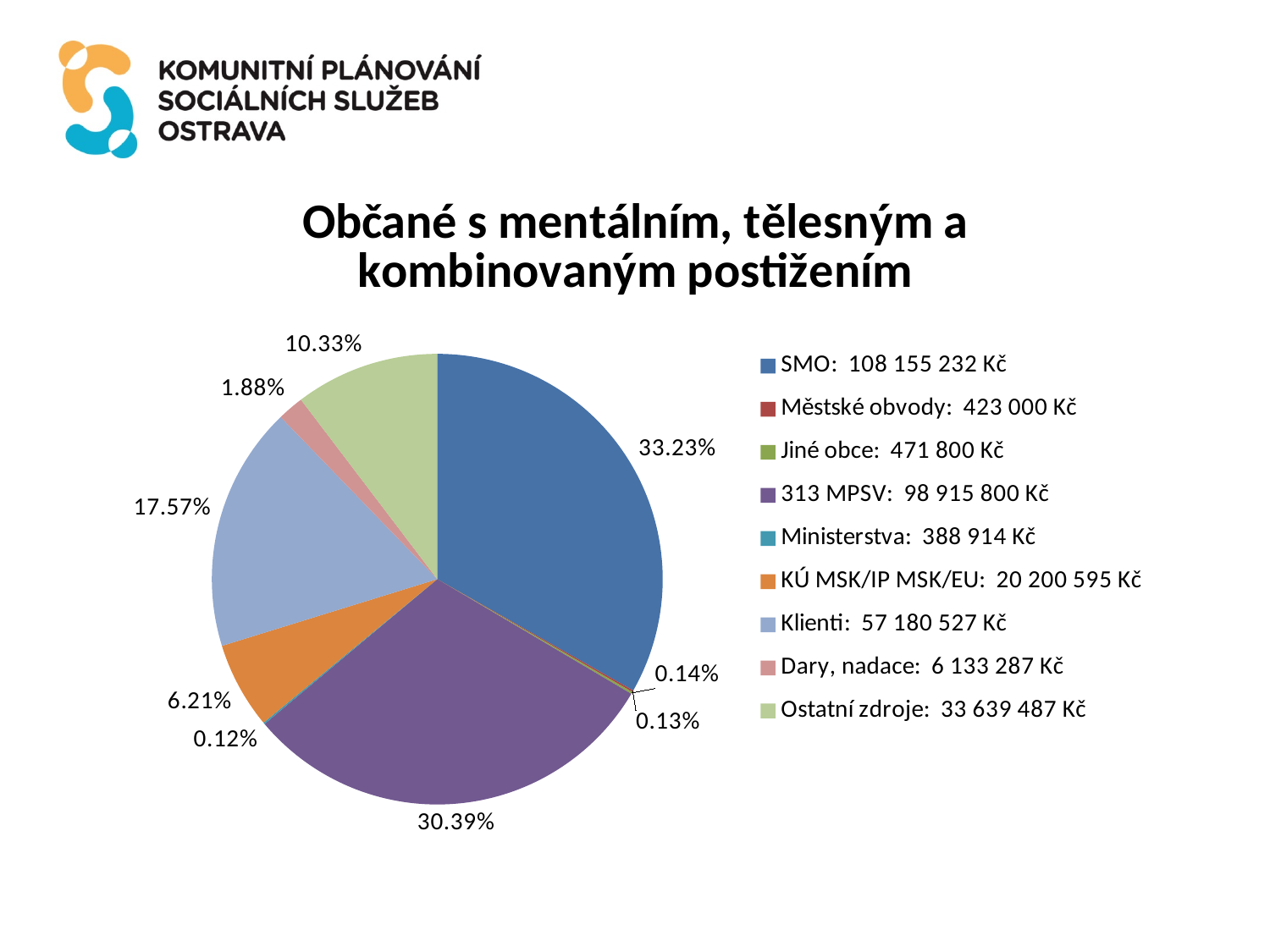
Which category has the smallest slice of the pie? Ministerstva What share of the pie does 313 MPSV represent? 30.39% What amount is listed for Klienti in the legend? 57 180 527 Kč What amount is listed for SMO in the legend? 108 155 232 Kč How many slices does the pie chart have? 9 What share of the pie does Ostatní zdroje represent? 10.33% What amount is listed for KÚ MSK/IP MSK/EU in the legend? 20 200 595 Kč What is the title of the chart? Občané s mentálním, tělesným a kombinovaným postižením Which category has the largest slice of the pie? SMO What kind of chart is shown on the slide? pie chart What share of the pie does SMO represent? 33.23% What is the difference in percentage points between the SMO slice and the 313 MPSV slice? 2.84